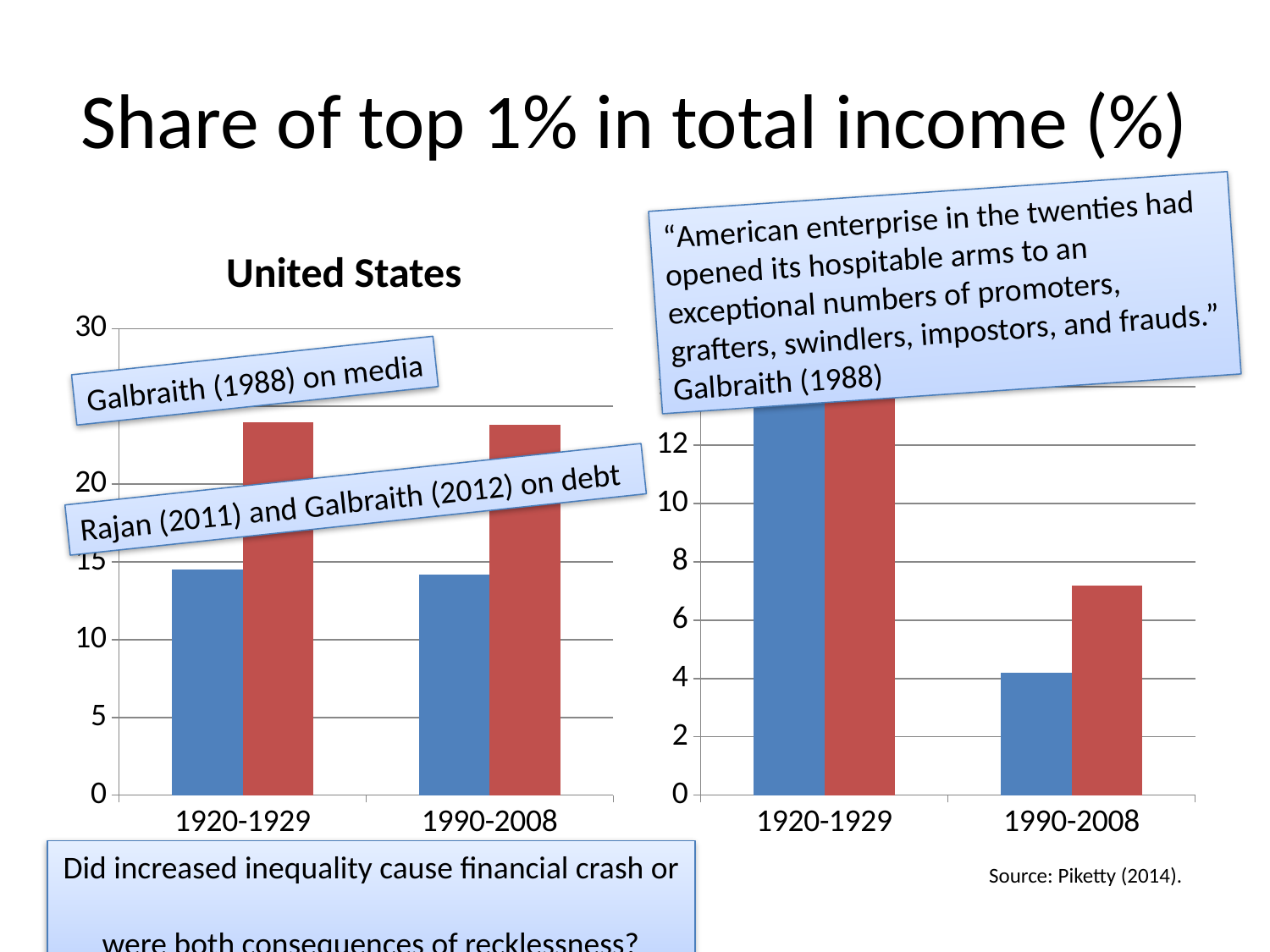
In the left chart titled "United States", is the red bar for 1990-2008 greater or less than 20? greater In the left chart titled "United States", is the red bar for 1920-1929 greater or less than 20? greater In the left chart titled "United States", for 1990-2008, which bar is taller, the blue one or the red one? the red one In the right chart, which category has the lowest blue bar? 1990-2008 How many categories are shown on the x axis of the left chart titled "United States"? 2 In the right chart, do the blue bars rise or fall from 1920-1929 to 1990-2008? fall How many categories are shown on the x axis of the right chart? 2 What kind of chart is the left chart titled "United States"? bar chart In the right chart, is the blue bar for 1990-2008 greater or less than 6? less What is the title of the left chart? United States